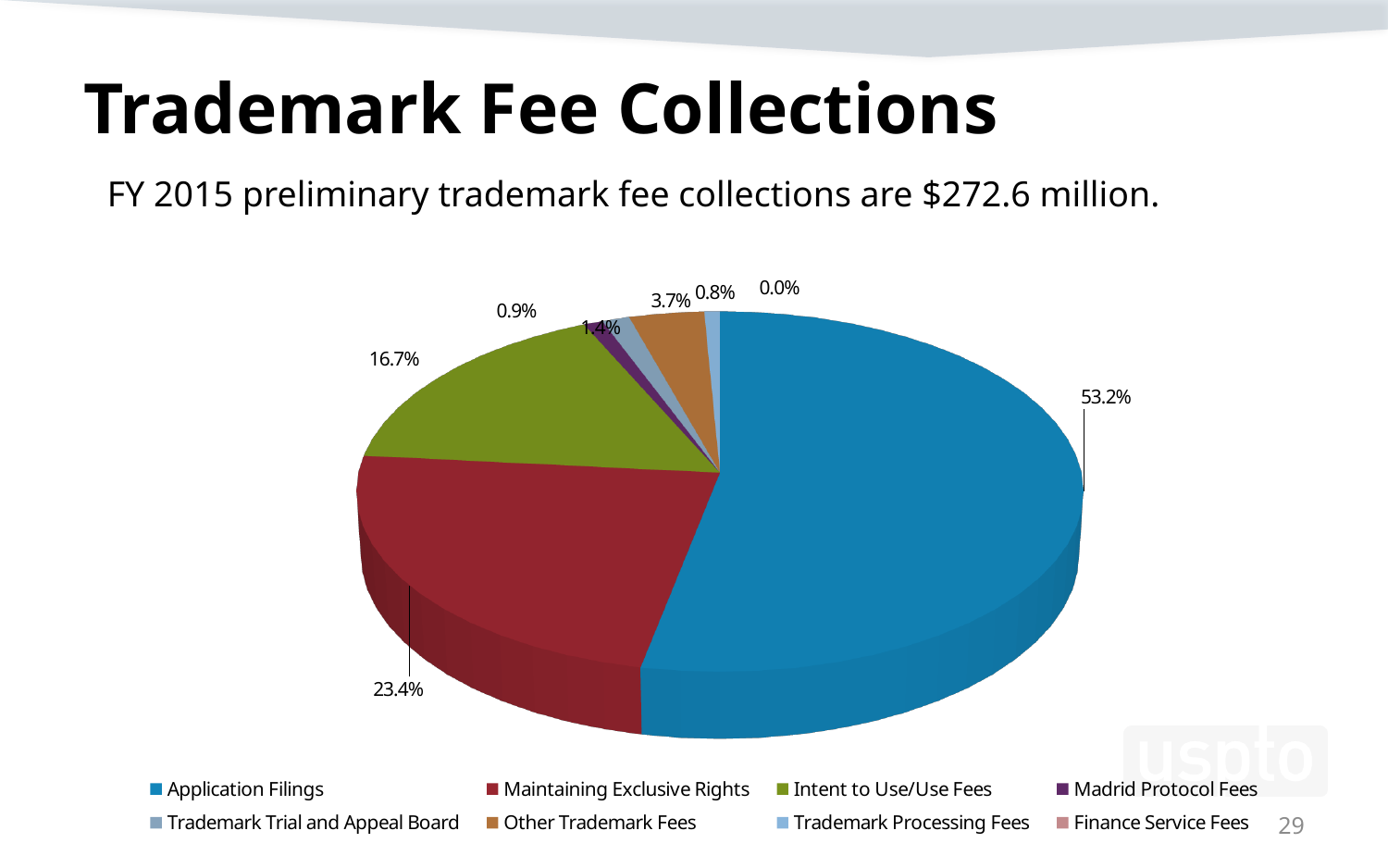
Which category has the smallest share of trademark fee collections? Finance Service Fees What colour is the Application Filings slice? blue What is the title of the chart slide? Trademark Fee Collections What share of trademark fee collections comes from Intent to Use/Use Fees? 16.7% What share of trademark fee collections comes from Other Trademark Fees? 3.7% Which is larger, the share for Maintaining Exclusive Rights or the share for Intent to Use/Use Fees? Maintaining Exclusive Rights What share of trademark fee collections comes from Maintaining Exclusive Rights? 23.4% How many categories does the legend list? 8 Which category has the largest share of trademark fee collections? Application Filings What kind of chart is shown on the slide? pie chart What is the difference in percentage points between the Application Filings share and the Maintaining Exclusive Rights share? 29.8